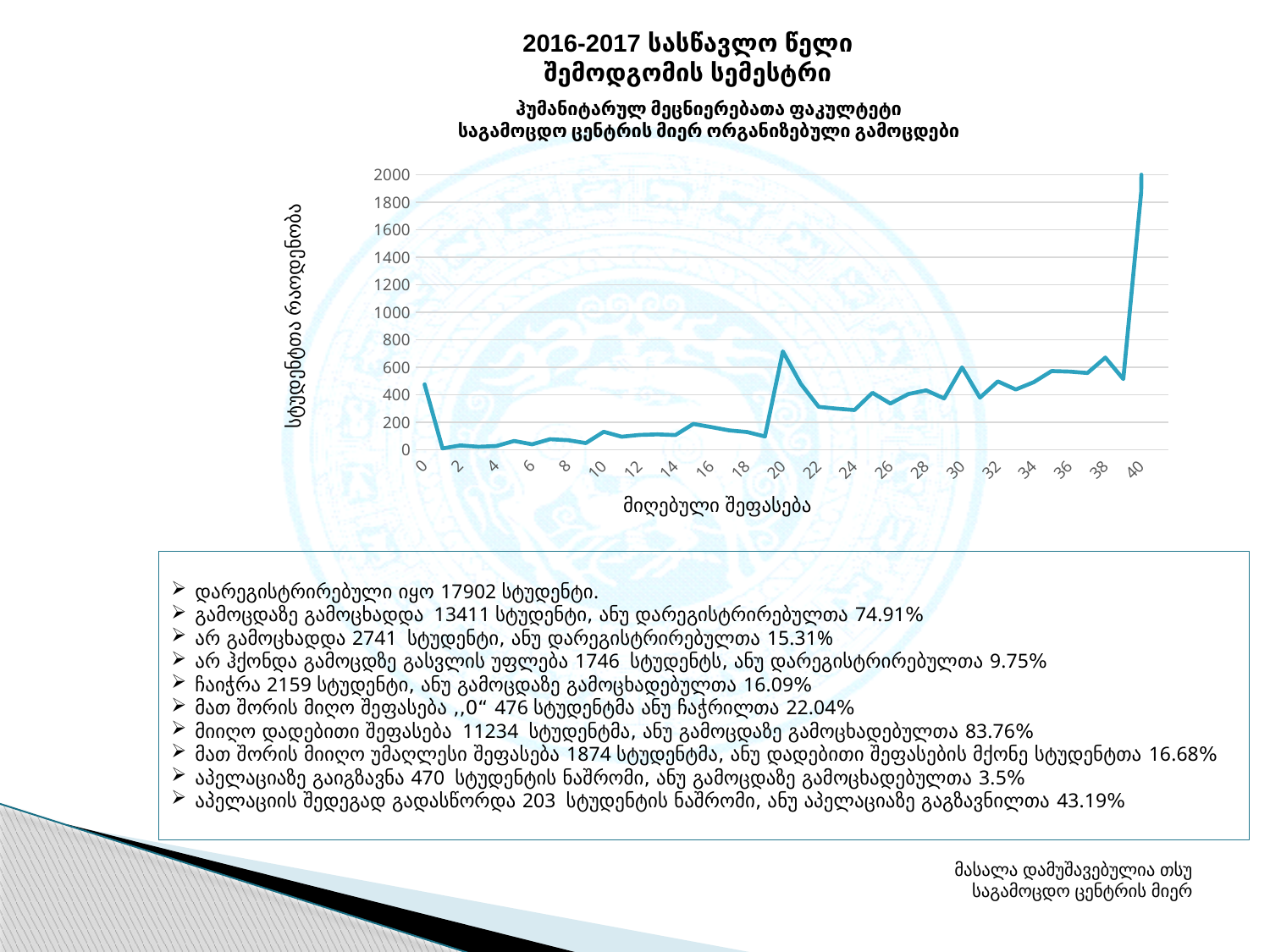
Between x = 20 and x = 40, does the line overall rise or fall? rise At which x-axis value (მიღებული შეფასება) does the line reach its highest point? 40 What kind of chart is shown on the slide? line chart Is the value at x = 0 greater or less than 400? greater Which has the larger value, x = 0 or x = 40? 40 Which has the larger value, x = 10 or x = 20? 20 What is the label of the y-axis? სტუდენტთა რაოდენობა Is the value at x = 2 greater or less than 200? less Is the value at x = 40 greater or less than 1800? greater What is the label of the x-axis? მიღებული შეფასება